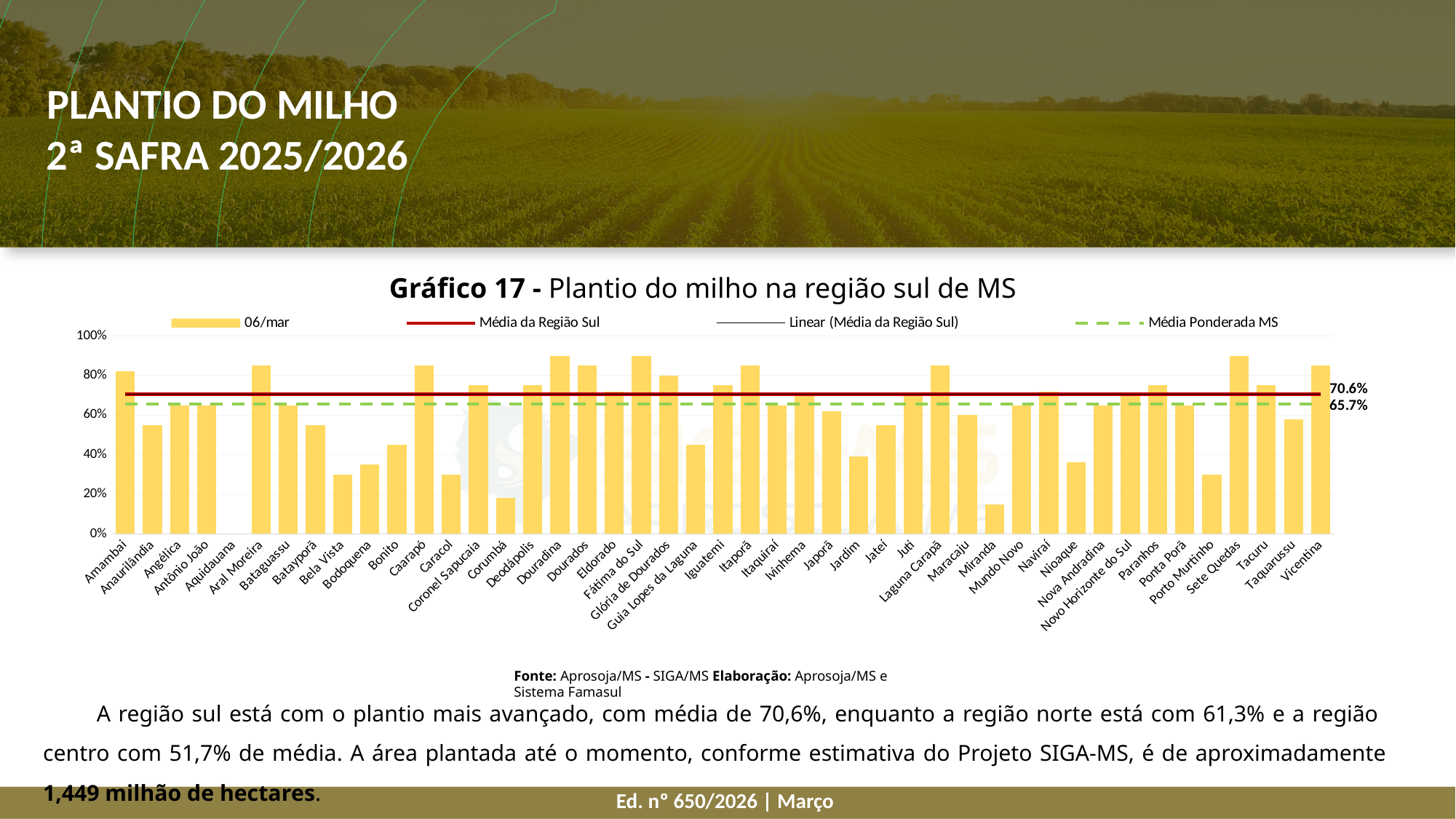
In Gráfico 17, which has the higher value, Amambai or Anaurilândia? Amambai In Gráfico 17, which has the higher value, Bela Vista or Bonito? Bonito Is the value for Douradina in Gráfico 17 greater or less than 80%? greater What value is labelled for the Média da Região Sul line in Gráfico 17? 70.6% What is the difference between the Média da Região Sul (70.6%) and the Média Ponderada MS (65.7%) in Gráfico 17? 4.9 percentage points What value is labelled for the Média Ponderada MS line in Gráfico 17? 65.7% Which is larger in Gráfico 17, the Média da Região Sul or the Média Ponderada MS? Média da Região Sul How many municipalities are listed on the x axis of Gráfico 17? 45 Is the value for Corumbá in Gráfico 17 greater or less than 20%? less How many entries does the legend of Gráfico 17 list? 4